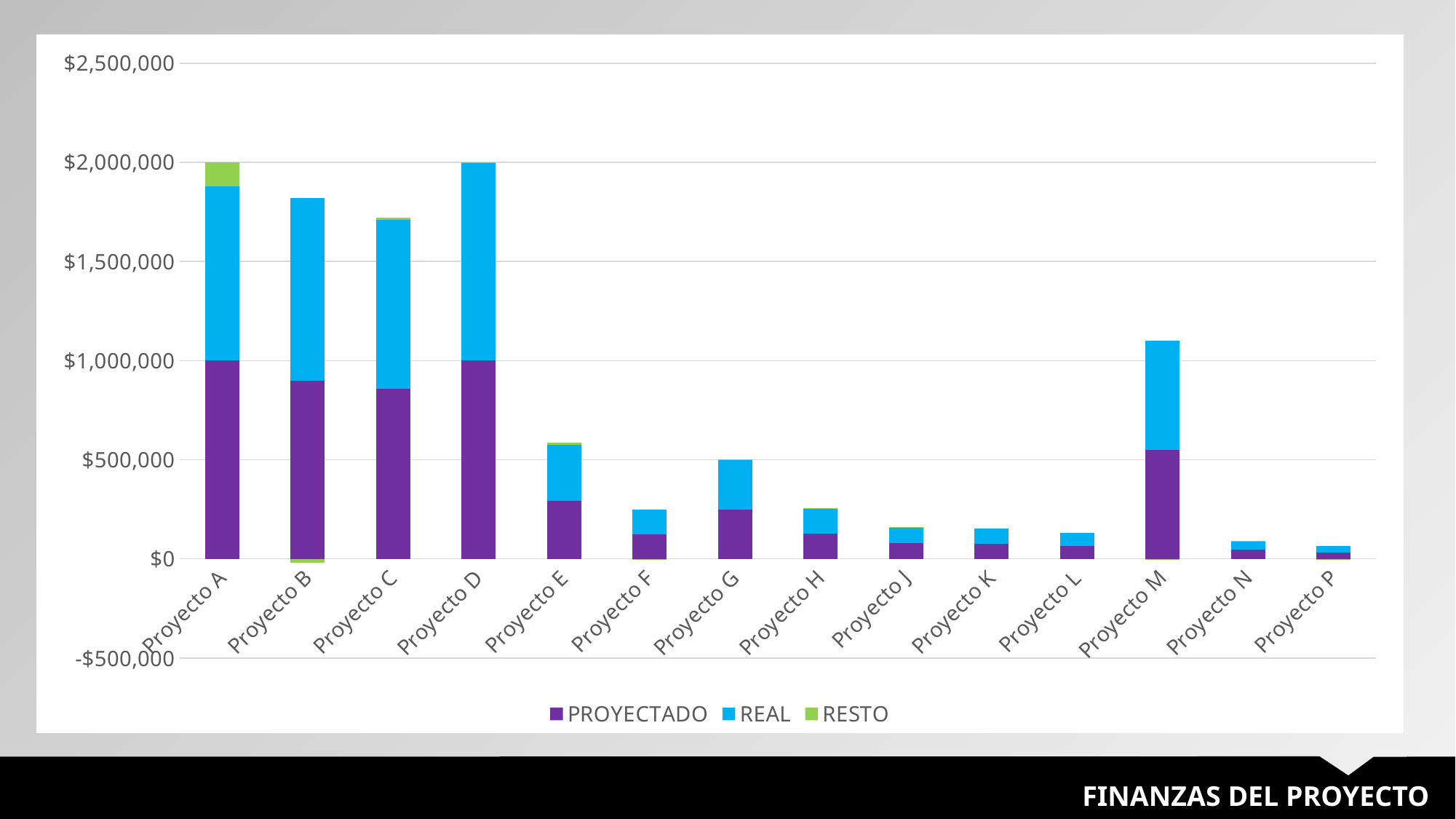
How many projects (categories) are shown on the x axis? 14 How many series does the legend list? 3 What is the total height of the stacked bar for Proyecto D? $2,000,000 What is the PROYECTADO value for Proyecto A? $1,000,000 Which has the larger total stacked bar, Proyecto M or Proyecto G? Proyecto M Is the total value for Proyecto M greater or less than $1,000,000? greater Is the total value for Proyecto F greater or less than $500,000? less What are the three series named in the legend? PROYECTADO, REAL, RESTO Is the total value for Proyecto B greater or less than $1,500,000? greater Which colour represents the PROYECTADO series? Purple What kind of chart is shown on the slide? Stacked bar chart